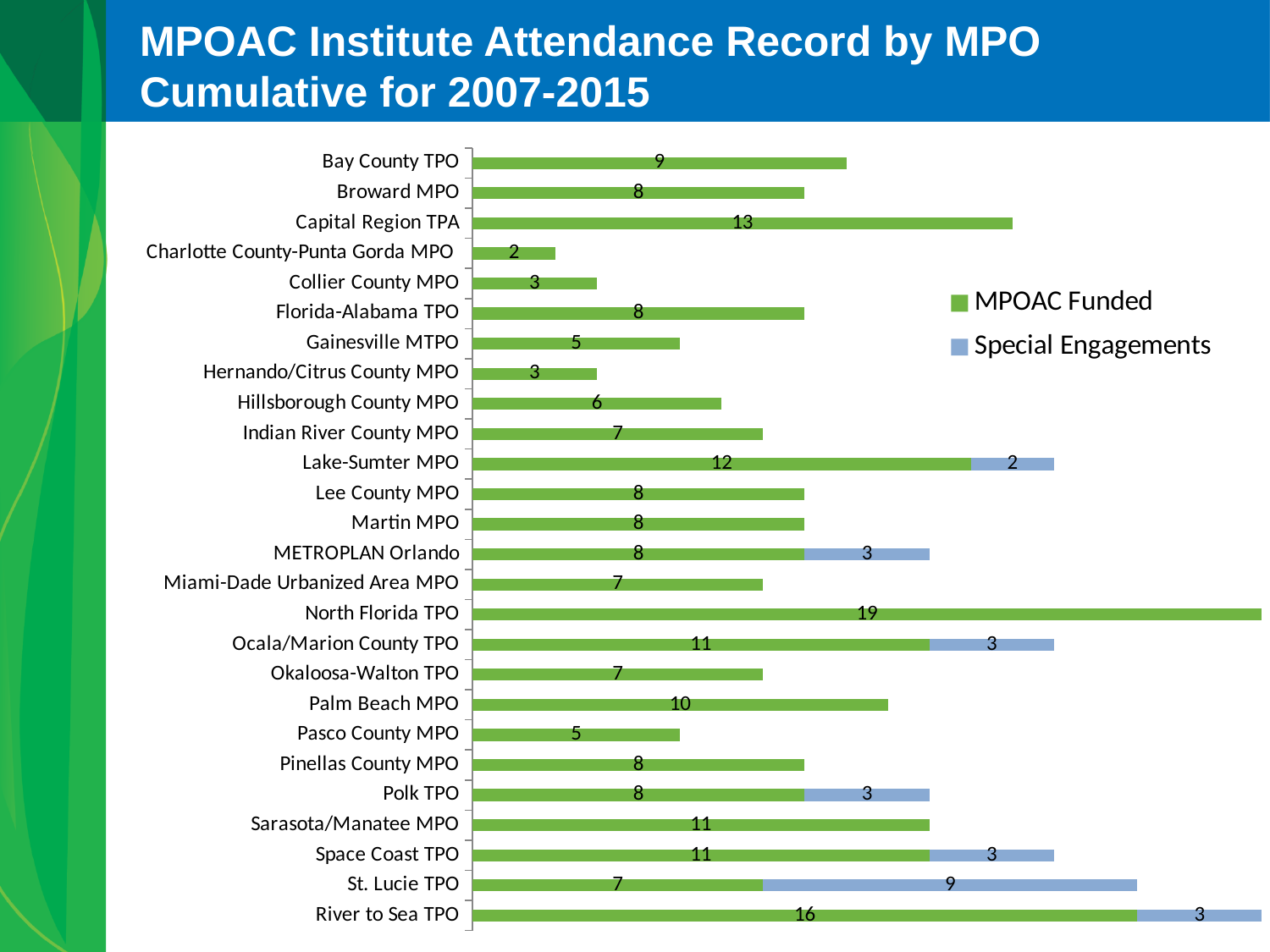
What kind of chart is shown on the slide? Bar chart How many MPOs are listed on the chart? 26 Which MPO has the highest Special Engagements value? St. Lucie TPO Which has a larger MPOAC Funded value, Space Coast TPO or Hillsborough County MPO? Space Coast TPO Which MPO has the lowest MPOAC Funded value? Charlotte County-Punta Gorda MPO What is the MPOAC Funded value for Capital Region TPA? 13 Which series is shown in blue in the legend? Special Engagements How many series does the legend list? 2 What is the difference between the MPOAC Funded values for North Florida TPO and Palm Beach MPO? 9 What is the Special Engagements value for St. Lucie TPO? 9 What is the total attendance (both series) for River to Sea TPO? 19 Which MPO has the highest MPOAC Funded value? North Florida TPO